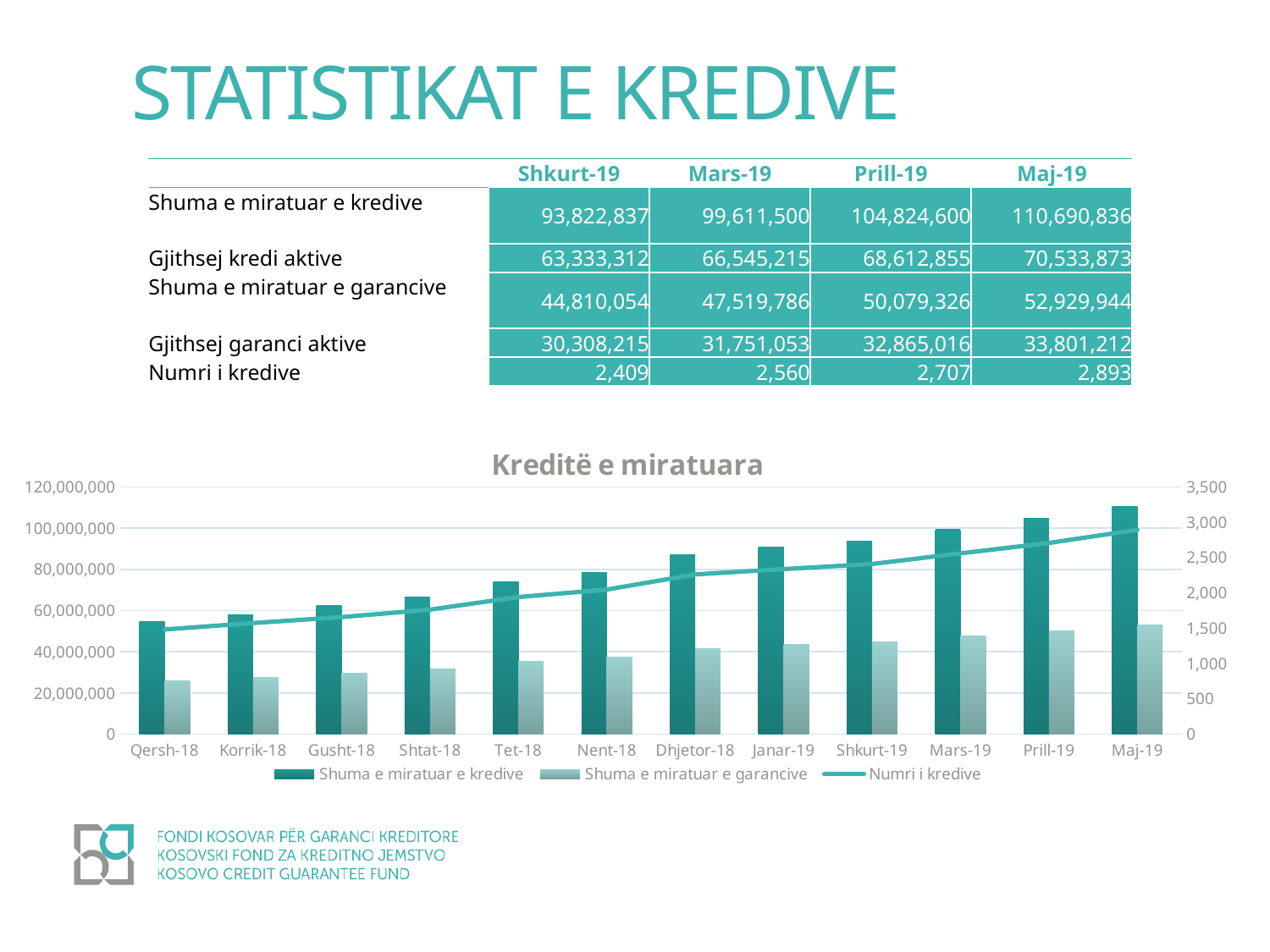
What kind of chart is shown under the title 'Kreditë e miratuara'? Bar chart with a line series According to the slide, what is the value of Shuma e miratuar e kredive for Maj-19? 110,690,836 In the 'Kreditë e miratuara' chart, which is larger in Maj-19: Shuma e miratuar e kredive or Shuma e miratuar e garancive? Shuma e miratuar e kredive In the 'Kreditë e miratuara' chart, which month has the lowest value for Shuma e miratuar e garancive? Qersh-18 How many series does the legend of the 'Kreditë e miratuara' chart list? 3 In the 'Kreditë e miratuara' chart, is the value for Shuma e miratuar e garancive in Qersh-18 greater or less than 40,000,000? less In the 'Kreditë e miratuara' chart, do the values for Shuma e miratuar e kredive rise or fall from Qersh-18 to Maj-19? Rise How many months are shown on the x axis of the 'Kreditë e miratuara' chart? 12 What is the title of the chart on the slide? Kreditë e miratuara In the 'Kreditë e miratuara' chart, which month has the highest value for Shuma e miratuar e kredive? Maj-19 In the 'Kreditë e miratuara' chart, is the value for Shuma e miratuar e kredive in Maj-19 greater or less than 100,000,000? greater In the 'Kreditë e miratuara' chart, is the value for Shuma e miratuar e kredive in Qersh-18 greater or less than 40,000,000? greater